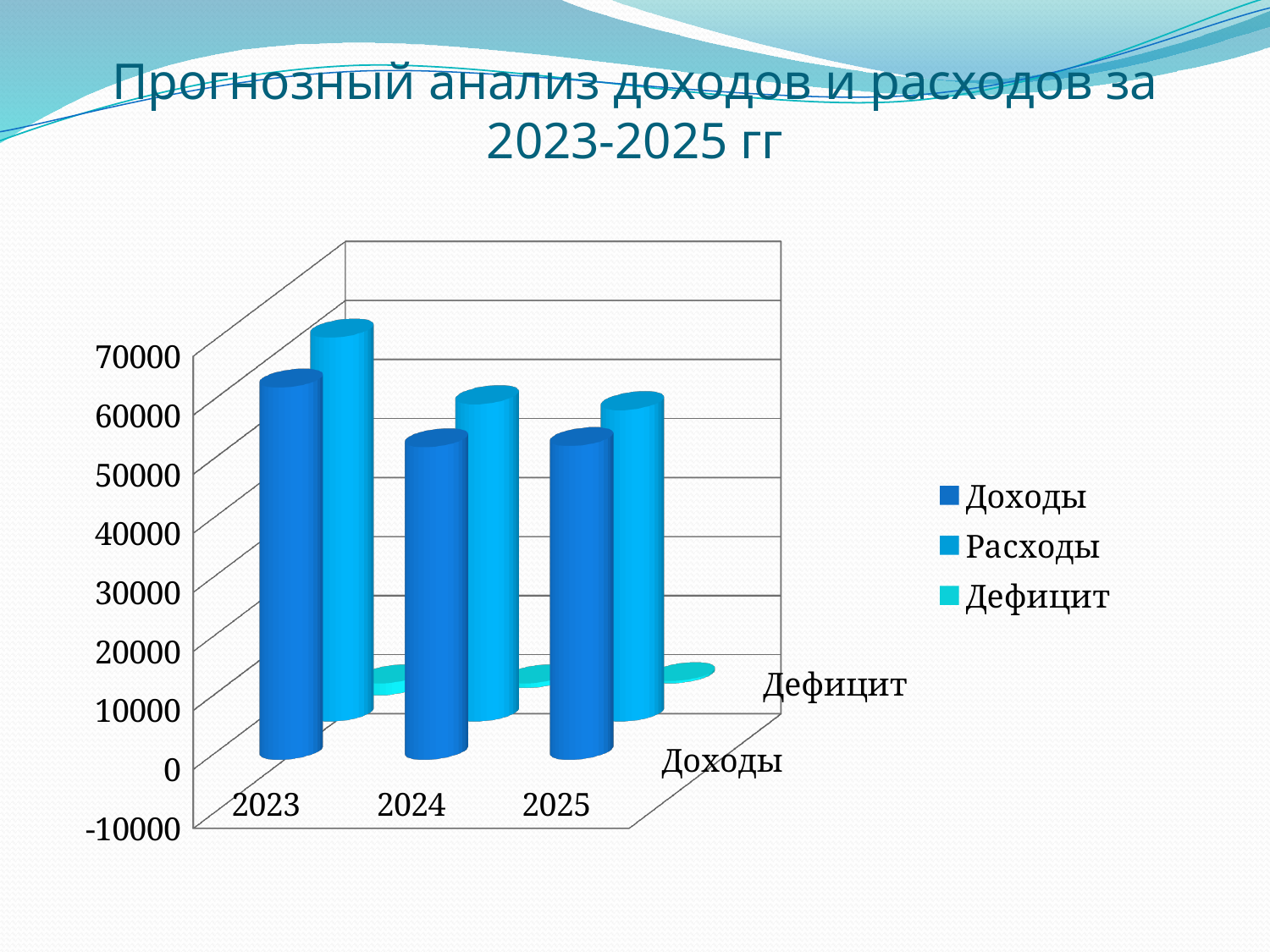
Is the value for Доходы in 2023 greater or less than 40000? greater Is the value for Расходы in 2023 greater or less than 60000? greater What is the title of the slide containing the chart? Прогнозный анализ доходов и расходов за 2023-2025 гг What kind of chart is shown on the slide? bar chart In which year is the value for Доходы the highest? 2023 What are the three series listed in the legend? Доходы, Расходы, Дефицит Is the value for Дефицит in 2025 greater or less than 10000? less How many series does the legend list? 3 How many years are shown on the x axis of the chart? 3 In which year is the value for Расходы the highest? 2023 In 2023, which is larger: Доходы or Расходы? Расходы